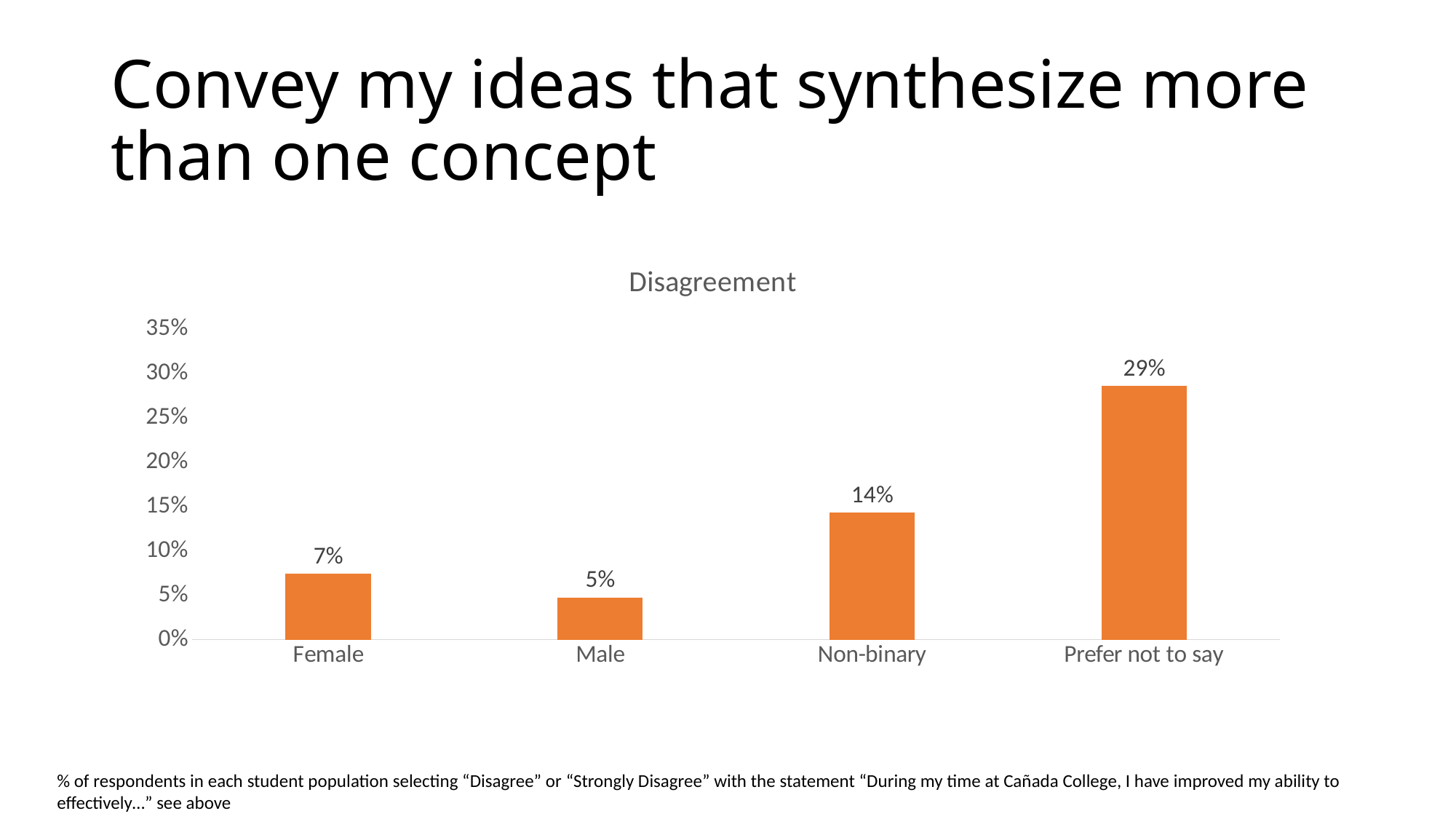
Is the value for Prefer not to say greater or less than 25%? greater What is the disagreement value for Female? 7% What kind of chart is shown on the slide? Bar chart How many categories are shown on the x axis? 4 Which category has the highest disagreement value? Prefer not to say What is the difference between the disagreement values for Female and Male? 2% What is the difference between the disagreement values for Prefer not to say and Non-binary? 15% Which is larger, the disagreement value for Non-binary or for Female? Non-binary What is the disagreement value for Non-binary? 14% Which category has the lowest disagreement value? Male What is the disagreement value for Prefer not to say? 29% What is the disagreement value for Male? 5%